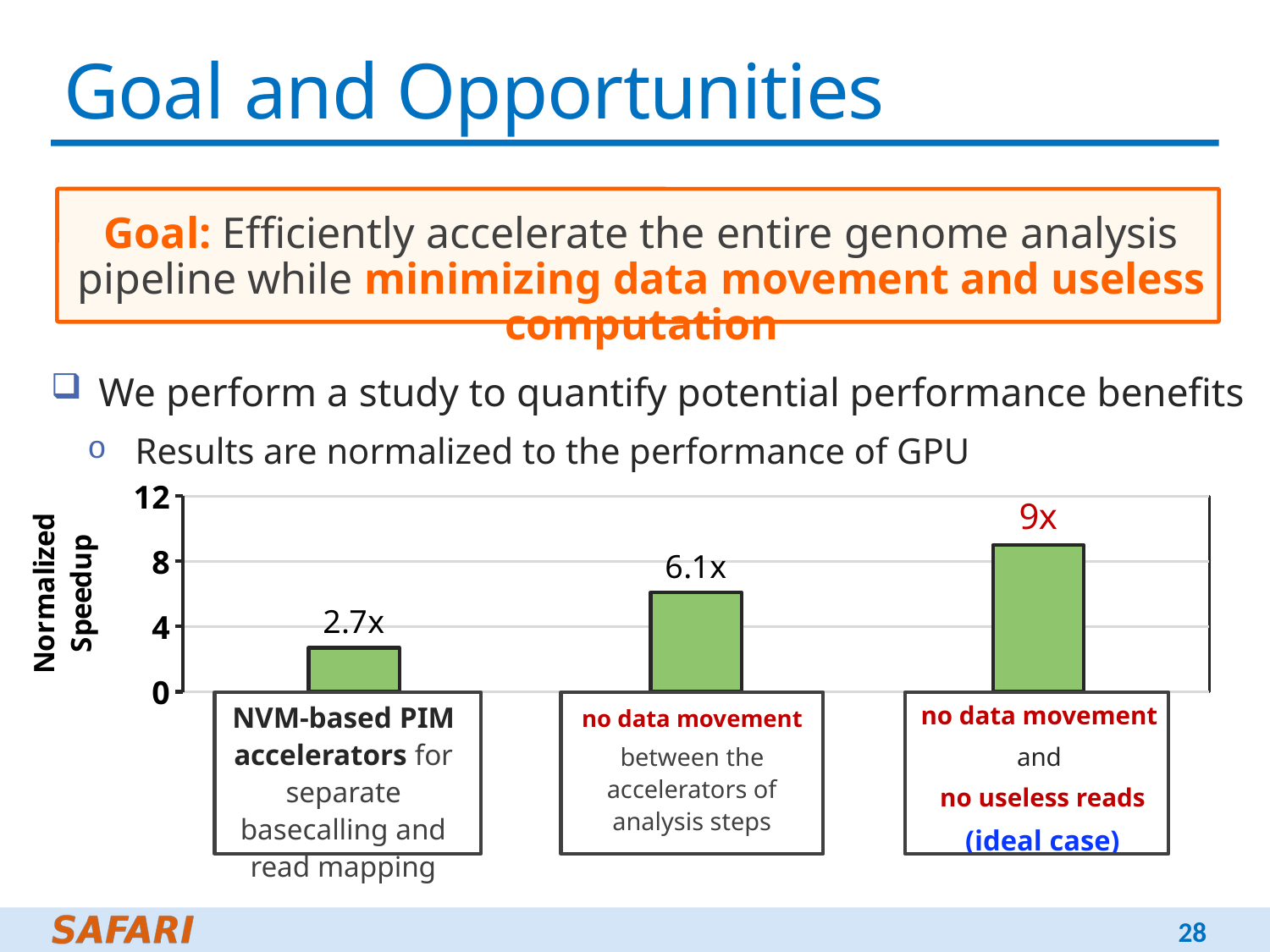
What is the normalized speedup for the ideal case with no data movement and no useless reads? 9x Is the normalized speedup for the ideal case greater or less than 8? greater How many bars are shown in the chart? 3 What is the normalized speedup for NVM-based PIM accelerators for separate basecalling and read mapping? 2.7x What kind of chart is shown on the slide? bar chart What is the label of the y axis of the chart? Normalized Speedup What is the difference in normalized speedup between the no data movement case and the NVM-based PIM accelerators case? 3.4x Which configuration has the lowest normalized speedup? NVM-based PIM accelerators for separate basecalling and read mapping What is the difference in normalized speedup between the ideal case and the no data movement case? 2.9x Which has a larger normalized speedup: NVM-based PIM accelerators or no data movement between accelerators? no data movement between accelerators What is the normalized speedup when there is no data movement between the accelerators of analysis steps? 6.1x Which configuration has the highest normalized speedup? no data movement and no useless reads (ideal case)